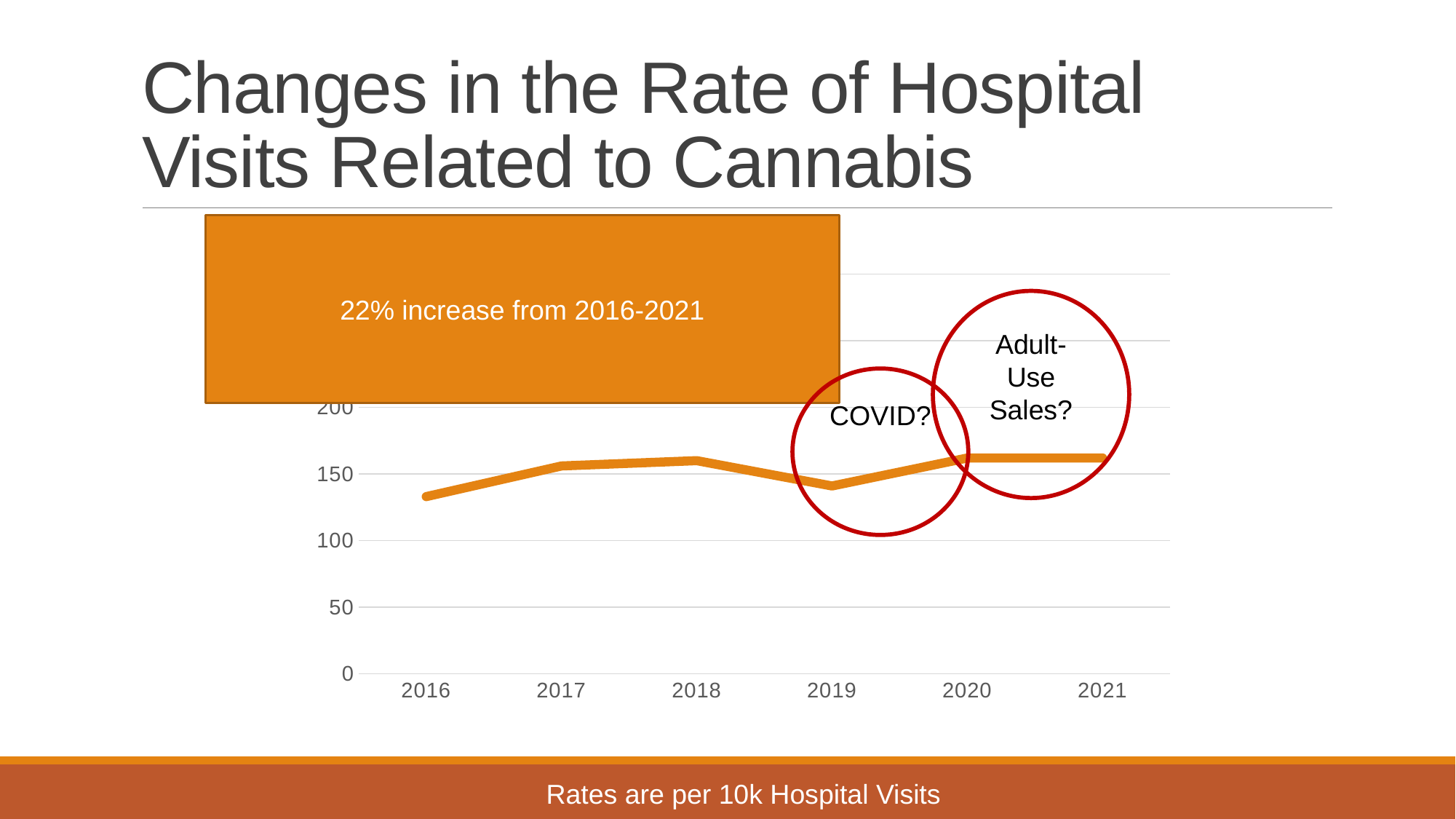
Is the value for 2019 greater or less than 150? less Which is larger, the value for 2017 or the value for 2019? 2017 What percentage increase from 2016-2021 does the annotation on the chart state? 22% Is the value for 2017 greater or less than 150? greater Is the value for 2021 greater or less than 150? greater According to the footer, what are the rates on the chart measured per? per 10k Hospital Visits What kind of chart is shown on the slide? line chart Which year has the lowest rate on the chart? 2016 Does the line rise or fall from 2018 to 2019? fall How many years are plotted along the x axis of the chart? 6